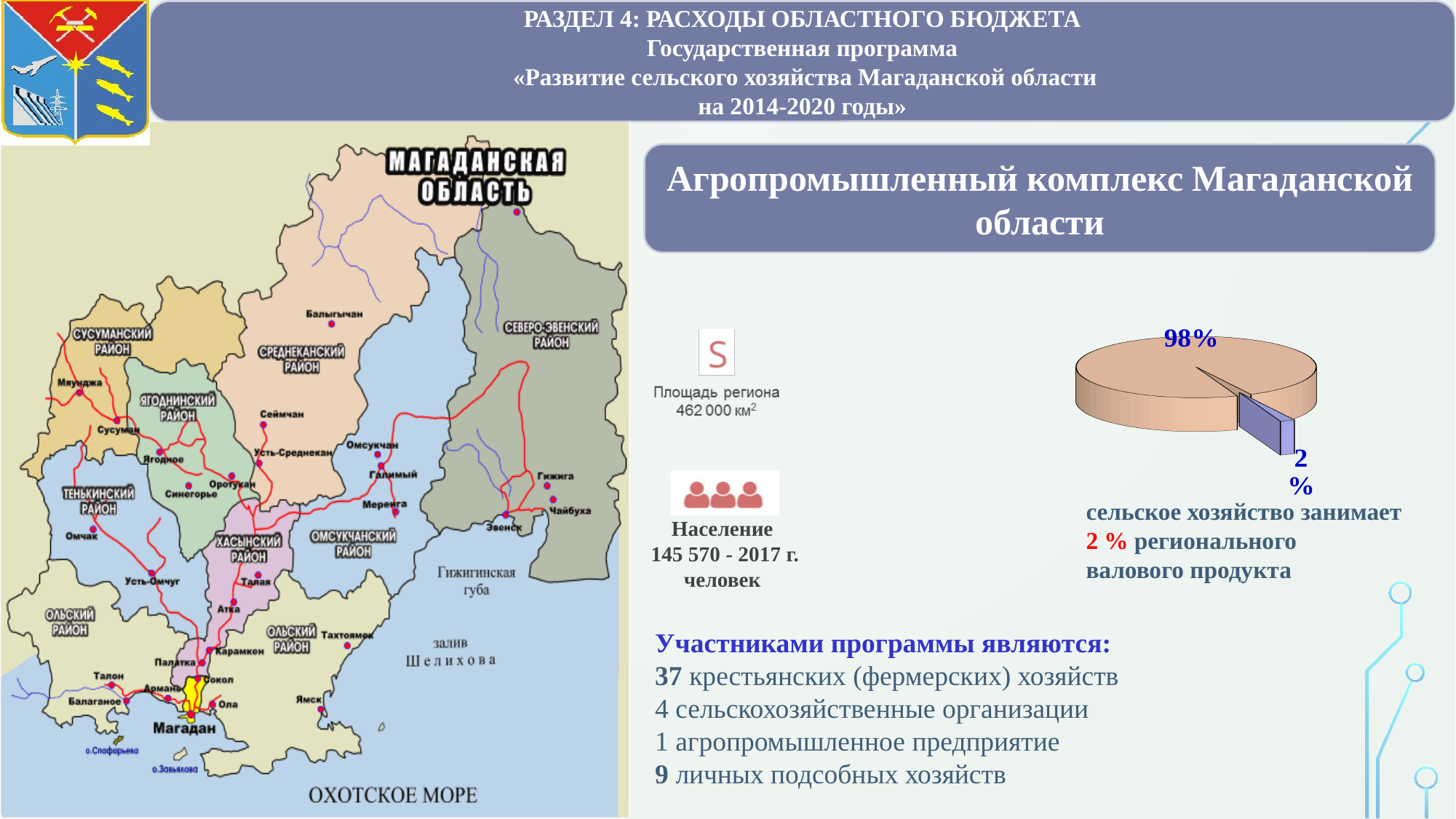
Is the value of the small blue slice of the pie chart greater or less than 50%? less How many slices does the pie chart have? 2 What colour is the slice representing 98% in the pie chart? tan (beige) Is the value of the large slice of the pie chart greater or less than 50%? greater What colour is the slice representing 2% in the pie chart? blue What is the difference in percentage points between the two slices of the pie chart? 96 What share of the regional gross product does agriculture occupy according to the pie chart? 2% What is the total of the two slice values shown on the pie chart? 100% What is the value of the largest slice of the pie chart? 98% What kind of chart is shown on the right side of the slide? pie chart Which slice of the pie chart is larger, the 98% slice or the 2% slice? 98% What is the value of the smallest slice of the pie chart? 2%